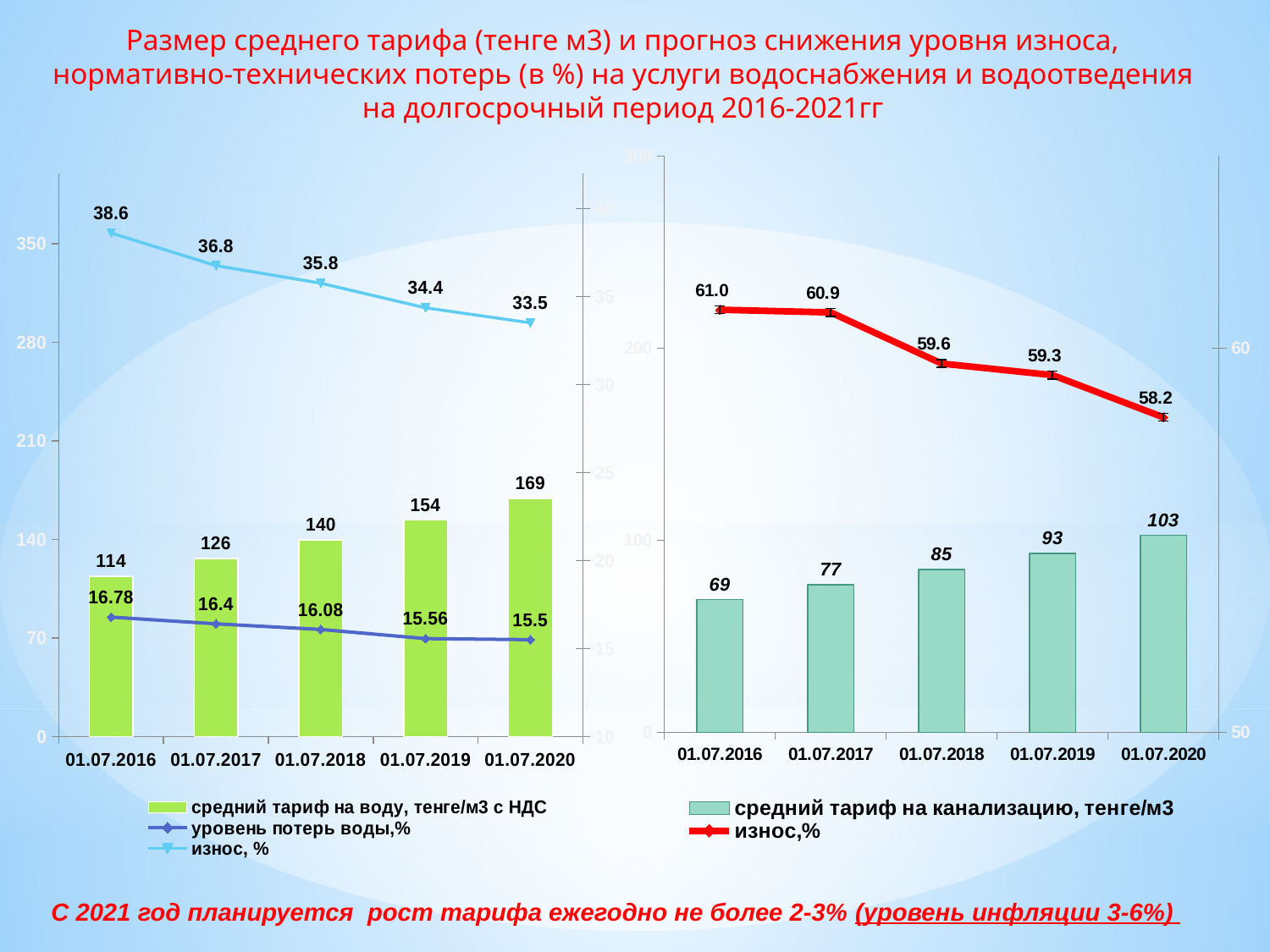
In the left chart, what is the wear (износ) value on 01.07.2020? 33.5 In the left chart, on which date is the average water tariff highest? 01.07.2020 In the right chart, what is the difference between the wear value on 01.07.2016 and on 01.07.2020? 2.8 In the right chart, how many dates are shown on the x axis? 5 In the left chart, does the wear (износ, %) line rise or fall from 01.07.2016 to 01.07.2020? fall In the left chart, what is the water loss level (уровень потерь воды) on 01.07.2016? 16.78 In the left chart, how many series does the legend list? 3 In the right chart, what is the wear (износ) value on 01.07.2018? 59.6 In the left chart, what is the average water tariff (средний тариф на воду) on 01.07.2018? 140 In the right chart, on which date is the sewerage tariff lowest? 01.07.2016 In the left chart, what is the difference between the water tariff on 01.07.2020 and on 01.07.2016? 55 In the right chart, what is the average sewerage tariff (средний тариф на канализацию) on 01.07.2019? 93